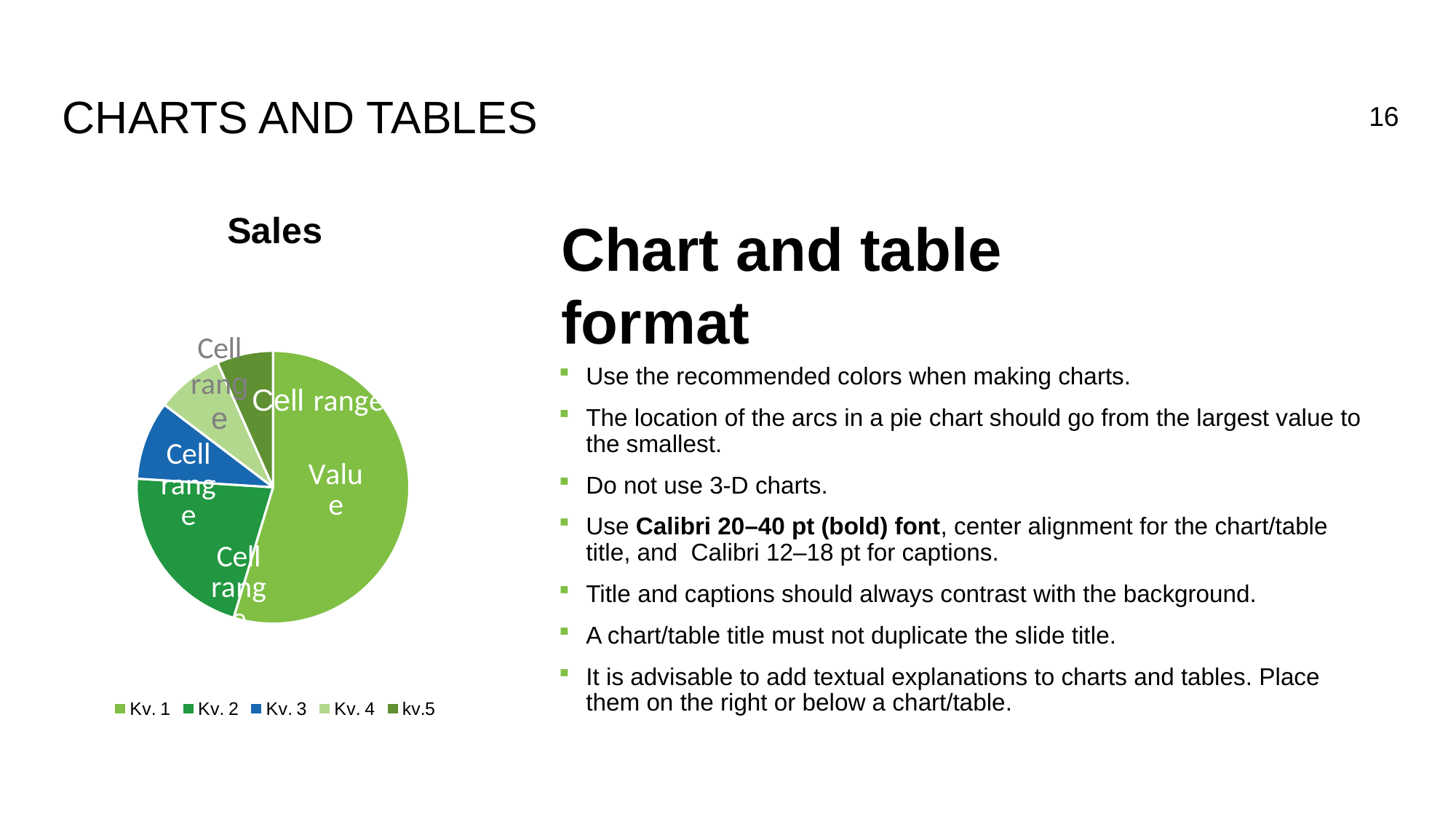
In the Sales pie chart, which slice is larger, Kv. 2 or Kv. 3? Kv. 2 How many entries does the legend of the Sales pie chart list? 5 In the Sales pie chart, which slice is larger, Kv. 1 or Kv. 2? Kv. 1 What is the title of the pie chart? Sales Which category has the largest slice in the Sales pie chart? Kv. 1 In the Sales pie chart, which slice is larger, Kv. 1 or Kv. 3? Kv. 1 How many slices does the Sales pie chart have? 5 What kind of chart is shown on the slide? pie chart What colour is the Kv. 3 slice in the Sales pie chart? blue